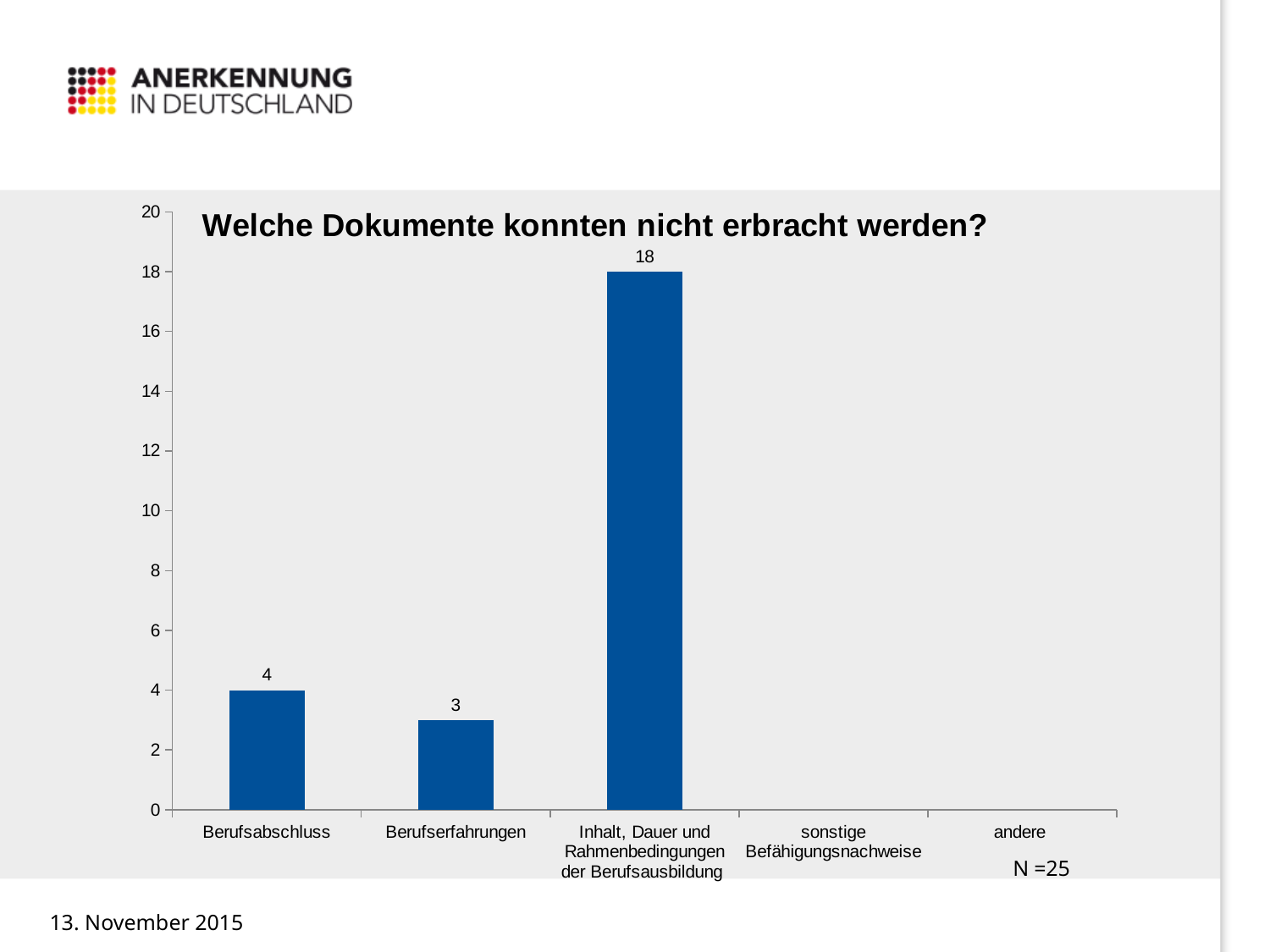
How many categories are shown on the x axis? 5 What kind of chart is shown on the slide? bar chart What is the difference between the values for Berufsabschluss and Berufserfahrungen? 1 What is the value for Inhalt, Dauer und Rahmenbedingungen der Berufsausbildung? 18 What is the difference between the values for Inhalt, Dauer und Rahmenbedingungen der Berufsausbildung and Berufsabschluss? 14 What is the value for Berufserfahrungen? 3 Which is larger, the value for Berufsabschluss or the value for Berufserfahrungen? Berufsabschluss What sample size (N) is stated on the chart? N =25 What is the value for Berufsabschluss? 4 Is the value for Inhalt, Dauer und Rahmenbedingungen der Berufsausbildung greater or less than 10? greater What is the title of the chart? Welche Dokumente konnten nicht erbracht werden? Which category has the highest value? Inhalt, Dauer und Rahmenbedingungen der Berufsausbildung